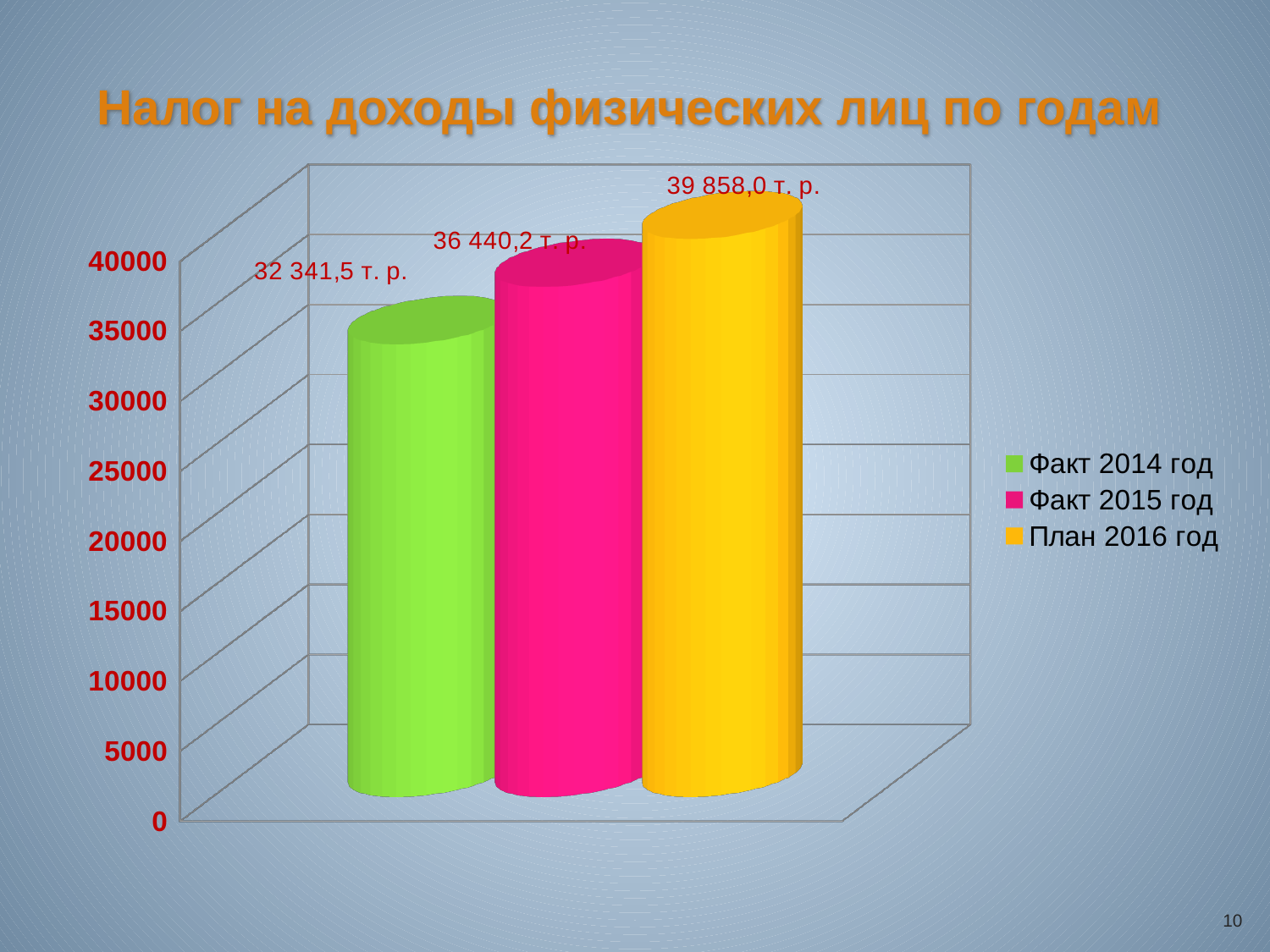
Which series has the highest value? План 2016 год What is the value for План 2016 год? 39 858,0 т. р. Which series has the lowest value? Факт 2014 год Is the value for Факт 2014 год greater or less than 35000? less What kind of chart is shown on the slide? bar chart What is the difference between the values for План 2016 год and Факт 2015 год? 3 417,8 т. р. What is the difference between the values for Факт 2015 год and Факт 2014 год? 4 098,7 т. р. What is the value for Факт 2015 год? 36 440,2 т. р. What is the value for Факт 2014 год? 32 341,5 т. р. What is the title of the chart? Налог на доходы физических лиц по годам How many series does the legend list? 3 Which is larger, the value for Факт 2014 год or the value for План 2016 год? План 2016 год